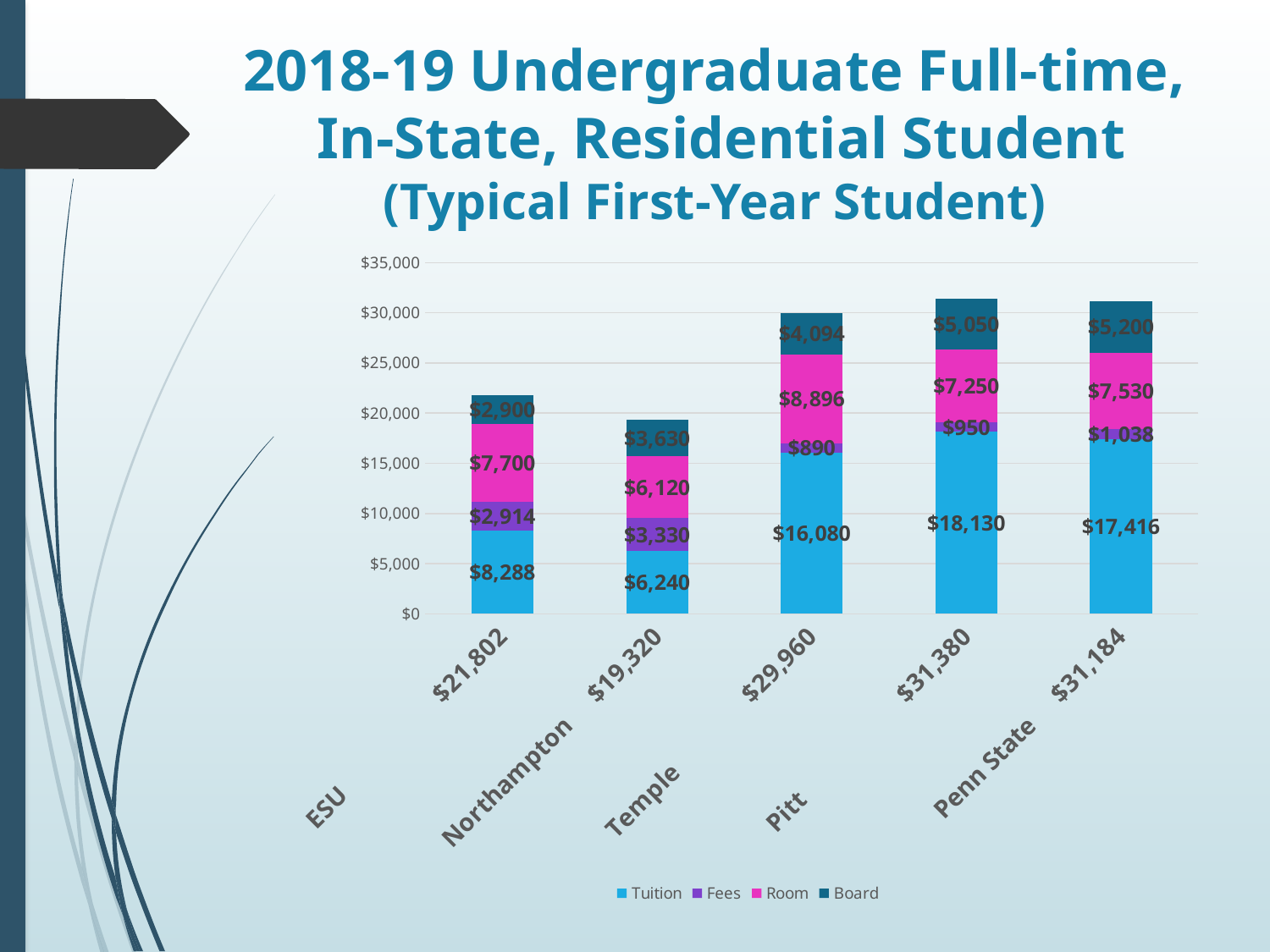
What is the difference between the Tuition values for Pitt and Penn State? $714 What is the Tuition value for Pitt? $18,130 Which institution has the highest total cost? Pitt What is the Fees value for Temple? $890 How many series does the legend list? 4 How many institutions are shown on the x axis? 5 What type of chart is shown on the slide? Stacked bar chart What is the Room value for Northampton? $6,120 What is the Board value for Penn State? $5,200 Which is larger, the Room value for ESU or the Room value for Penn State? ESU What is the total of the stacked bar for ESU? $21,802 Which institution has the lowest total cost? Northampton